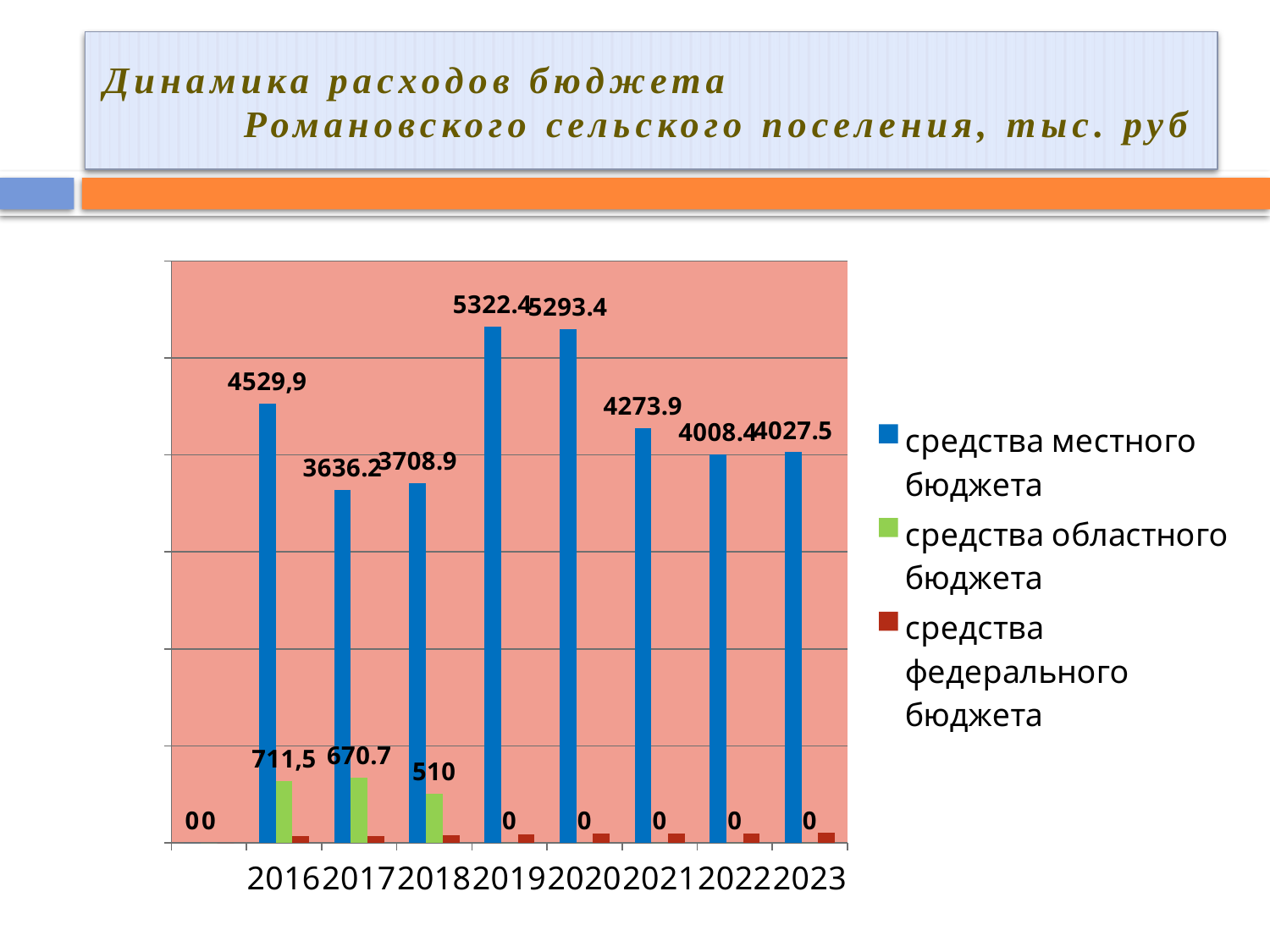
How many series does the legend list? 3 In which year is средства местного бюджета the highest? 2019 What is the value of средства местного бюджета for 2022? 4008.4 Which year has the larger value of средства областного бюджета, 2017 or 2018? 2017 What is the value of средства местного бюджета for 2019? 5322.4 What is the value of средства областного бюджета for 2018? 510 What is the difference between средства местного бюджета in 2019 and 2020? 29.0 In which year is средства местного бюджета the lowest? 2017 What is the value of средства областного бюджета for 2016? 711,5 Does средства местного бюджета rise or fall from 2019 to 2022? fall Which colour represents средства федерального бюджета in the legend? red What type of chart is shown on the slide? bar chart